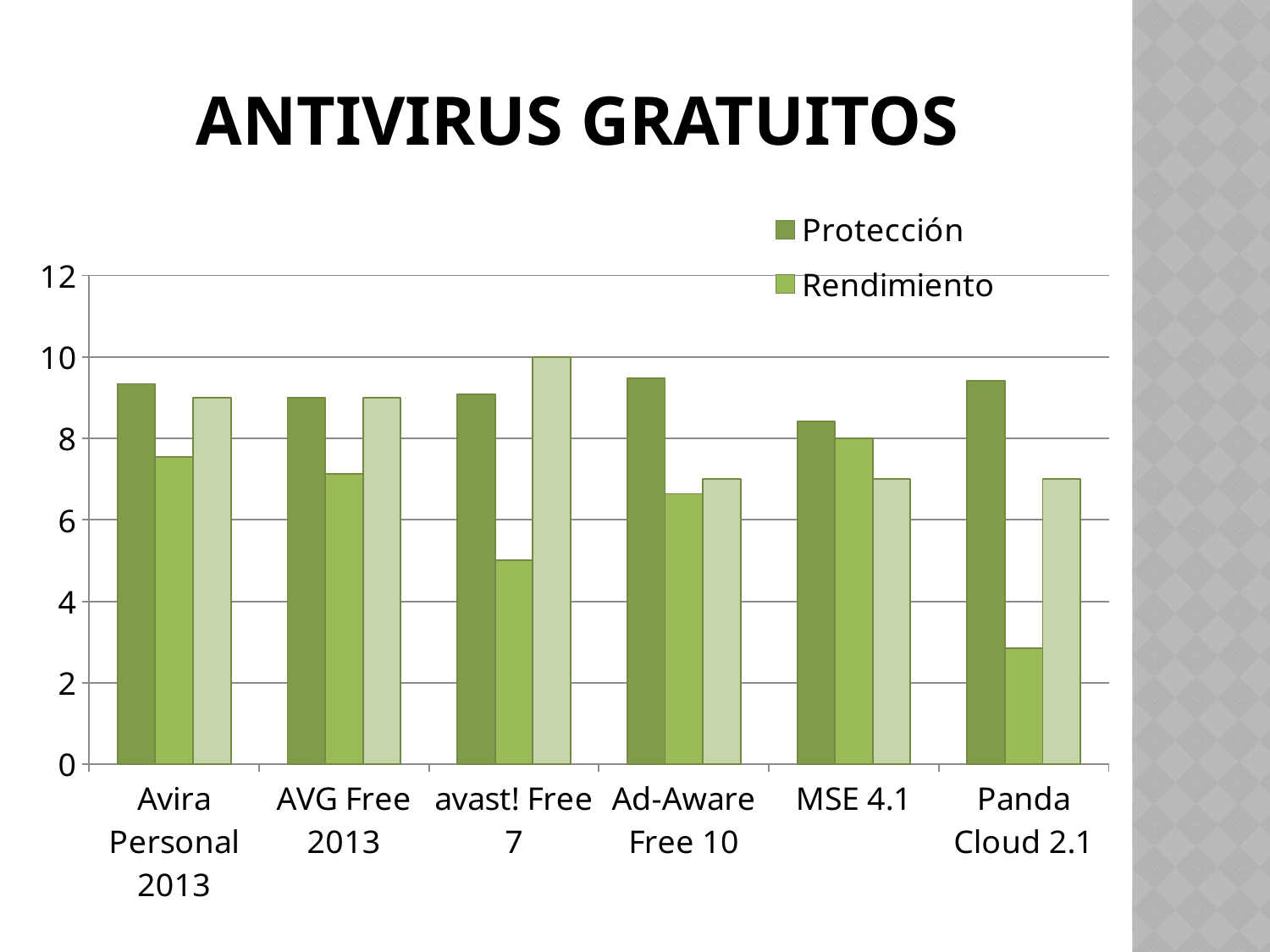
Which antivirus has the lowest Rendimiento value? Panda Cloud 2.1 Is the Rendimiento value for Panda Cloud 2.1 greater or less than 4? less Is the Protección value for Ad-Aware Free 10 greater or less than 8? greater How many antivirus products are shown on the x axis? 6 What kind of chart is shown on the slide? bar chart How many series does the legend list? 2 Which is larger for Avira Personal 2013, the Protección value or the Rendimiento value? Protección Which is larger, the Rendimiento value for MSE 4.1 or the Rendimiento value for Panda Cloud 2.1? MSE 4.1 Which antivirus has the lowest Protección value? MSE 4.1 Which antivirus has the highest Rendimiento value? MSE 4.1 What is the title of the chart? ANTIVIRUS GRATUITOS Is the Rendimiento value for avast! Free 7 greater or less than 6? less